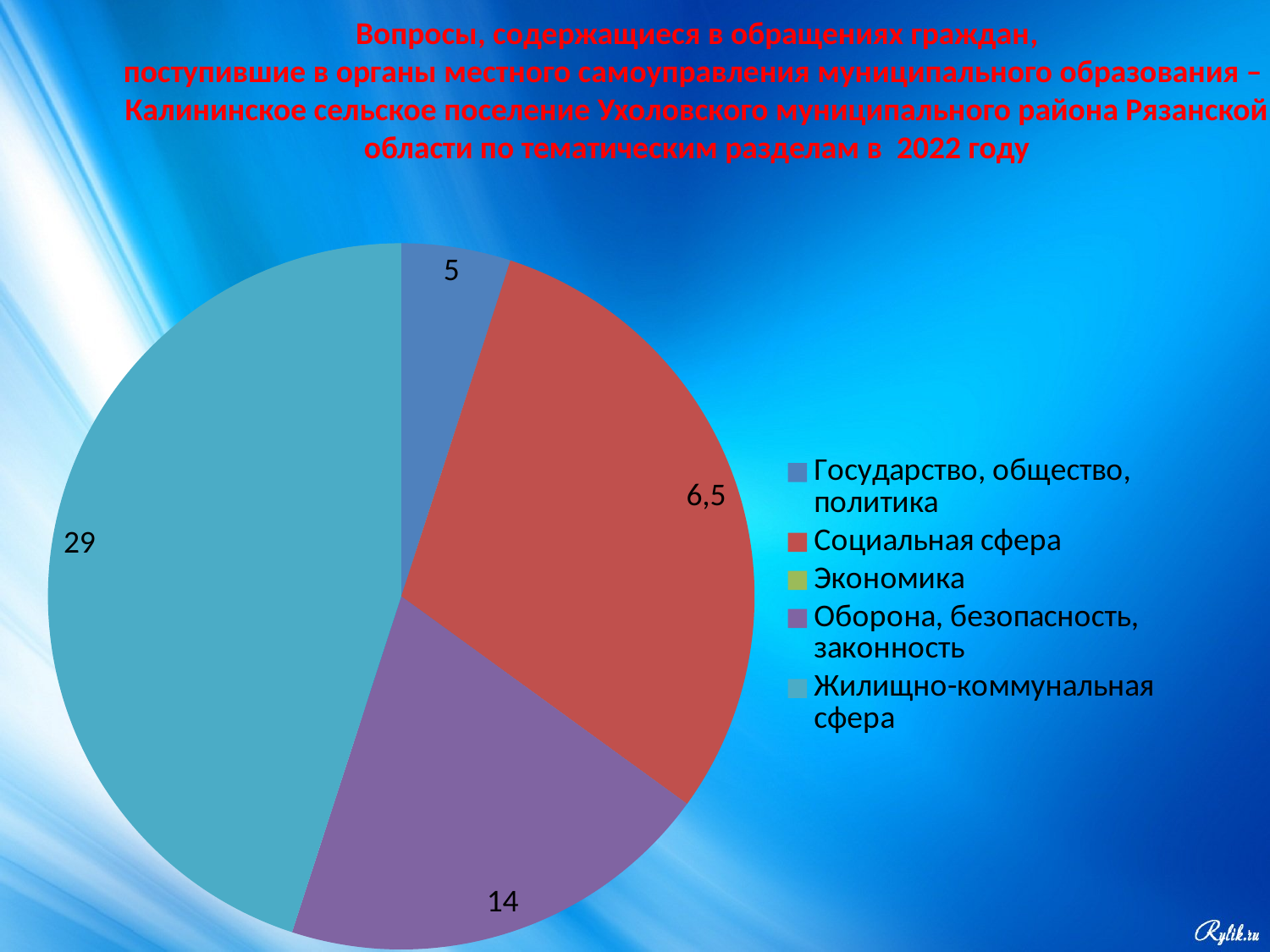
Which of the visible slices is the smallest? Государство, общество, политика What is the difference between the values for "Жилищно-коммунальная сфера" and "Государство, общество, политика"? 24 Which category has the largest slice of the pie? Жилищно-коммунальная сфера What value is shown for the slice "Государство, общество, политика"? 5 Which is larger: the slice for "Жилищно-коммунальная сфера" or the slice for "Оборона, безопасность, законность"? Жилищно-коммунальная сфера What value is labelled on the "Социальная сфера" slice? 6,5 What is the difference between the values for "Оборона, безопасность, законность" and "Государство, общество, политика"? 9 What kind of chart is shown on the slide? pie chart How many categories does the legend of the pie chart list? 5 What colour is the slice for "Социальная сфера"? red What value is shown for the slice "Оборона, безопасность, законность"? 14 What value is shown for the slice "Жилищно-коммунальная сфера"? 29